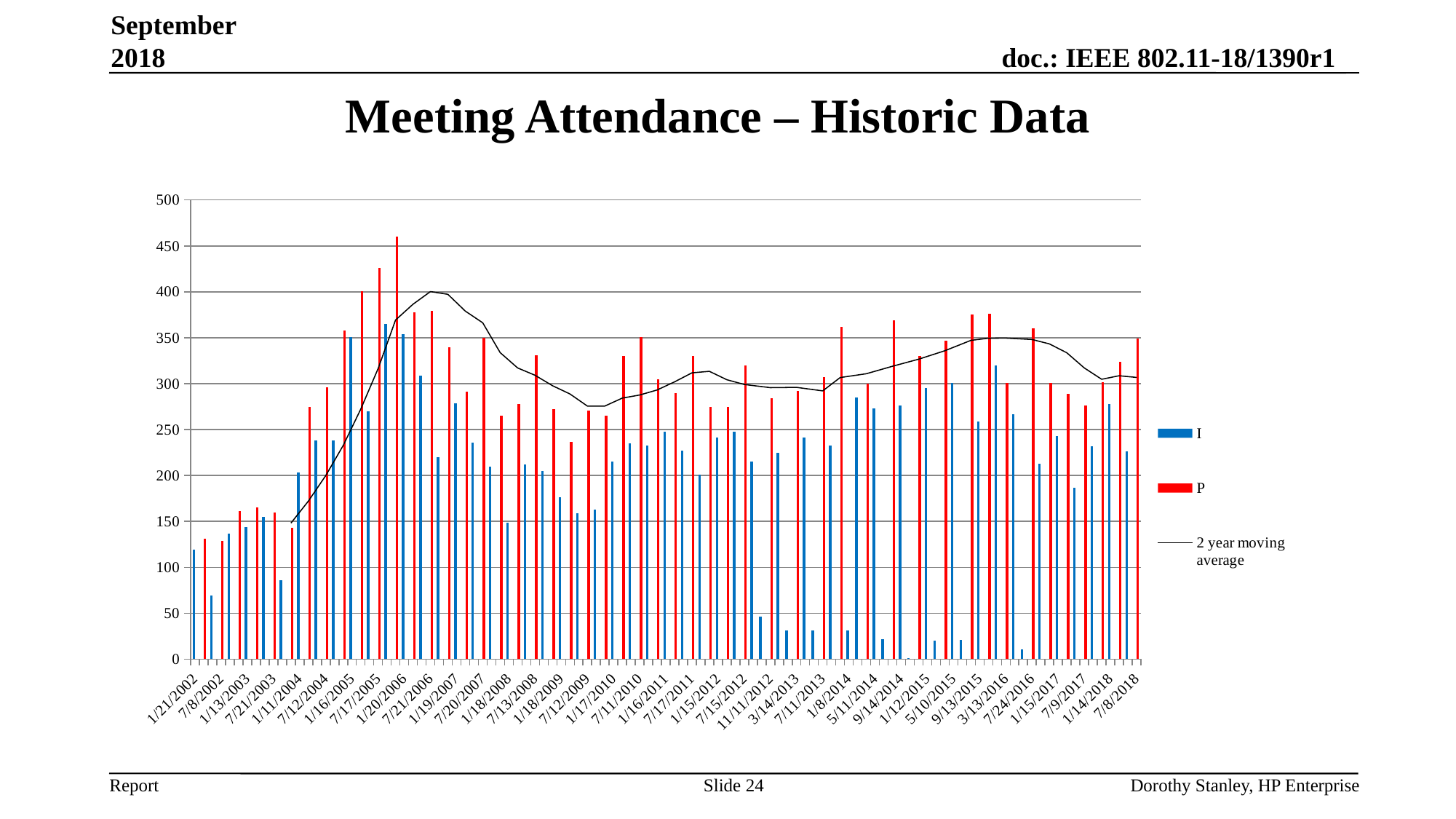
How many series does the legend list? 3 What is the maximum value shown on the vertical axis? 500 Is the highest P value in the chart greater or less than 450? greater Which colour represents the P series in the chart? Red Is the P value for 7/8/2018 greater or less than 300? greater What kind of chart is shown on the slide? Bar chart (with a moving average line) Is the I value for 1/21/2002 greater or less than 150? less Between 1/21/2002 and 1/20/2006, does the 2 year moving average line rise or fall? rise What is the title of the chart? Meeting Attendance – Historic Data